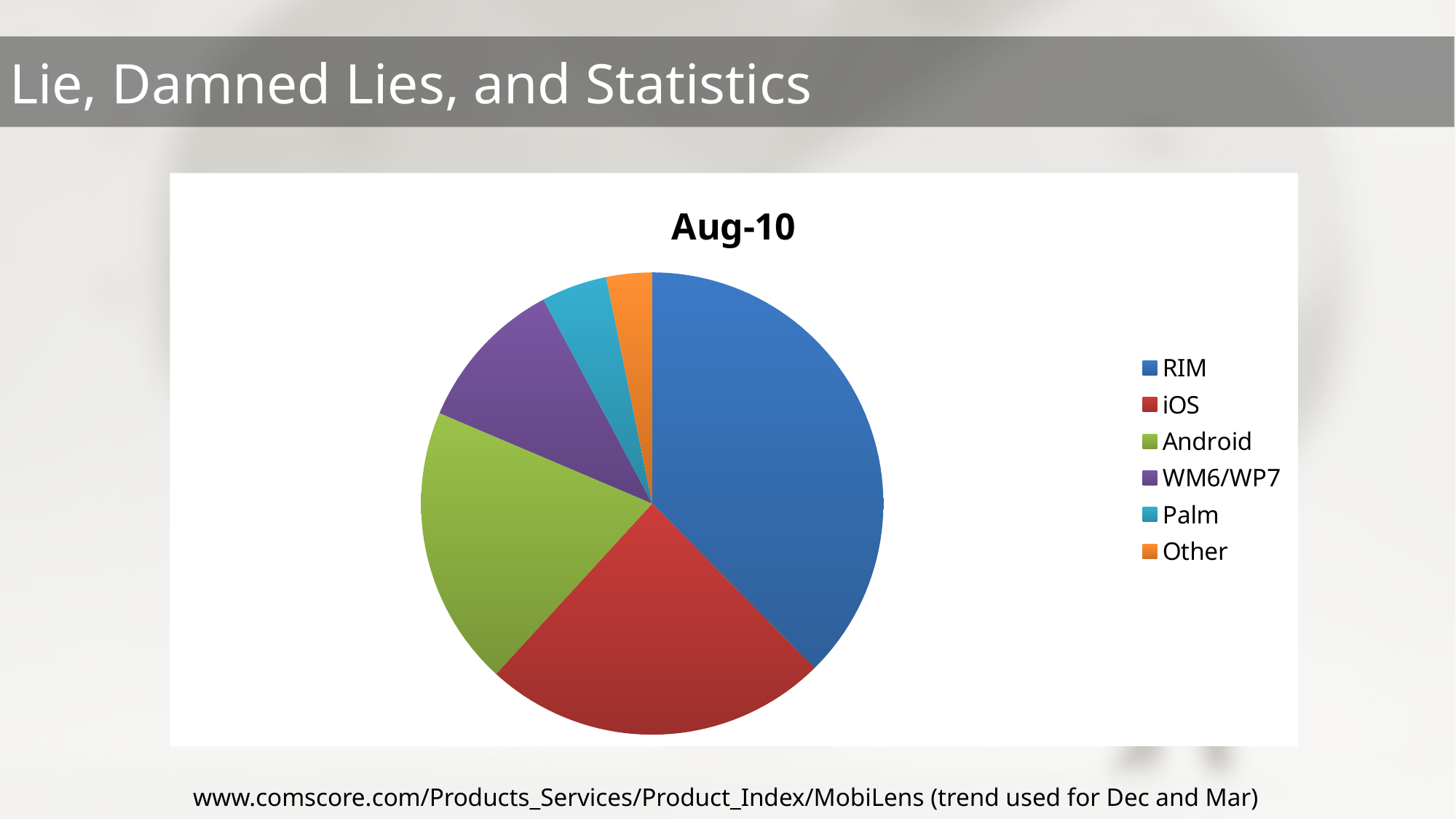
What kind of chart is shown on the slide? pie chart Which slice is larger, WM6/WP7 or Palm? WM6/WP7 Which slice is larger, iOS or Palm? iOS Which slice is larger, Android or WM6/WP7? Android How many slices does the pie chart have? 6 What is the title of the chart? Aug-10 Which category has the largest slice of the pie? RIM Which category is shown in orange in the pie chart? Other How many categories does the legend of the chart list? 6 Which colour represents Android in the pie chart? green